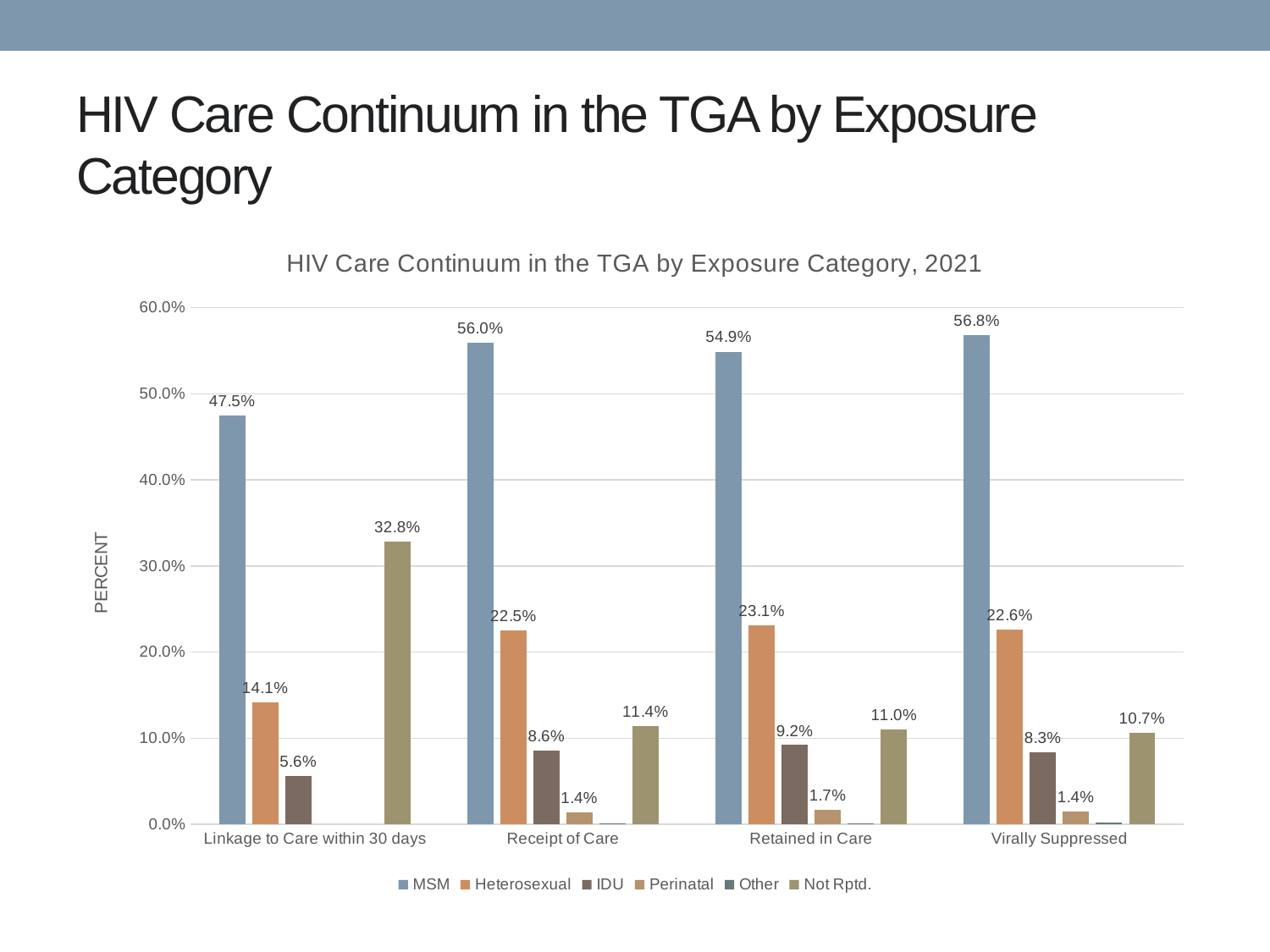
What is the value for Heterosexual in the Retained in Care category? 23.1% Do the Not Rptd. values rise or fall from Linkage to Care within 30 days to Virally Suppressed? Fall In which category is the Not Rptd. value lowest? Virally Suppressed In which category is the MSM value highest? Virally Suppressed What is the value for MSM in the Linkage to Care within 30 days category? 47.5% Which is larger: the IDU value for Retained in Care or the IDU value for Receipt of Care? Retained in Care How many series does the legend list? 6 What is the value for Perinatal in the Retained in Care category? 1.7% What is the difference between the MSM and Heterosexual values in the Receipt of Care category? 33.5% How many categories are shown on the x axis? 4 What is the value for Not Rptd. in the Linkage to Care within 30 days category? 32.8% What kind of chart is shown on the slide? Bar chart